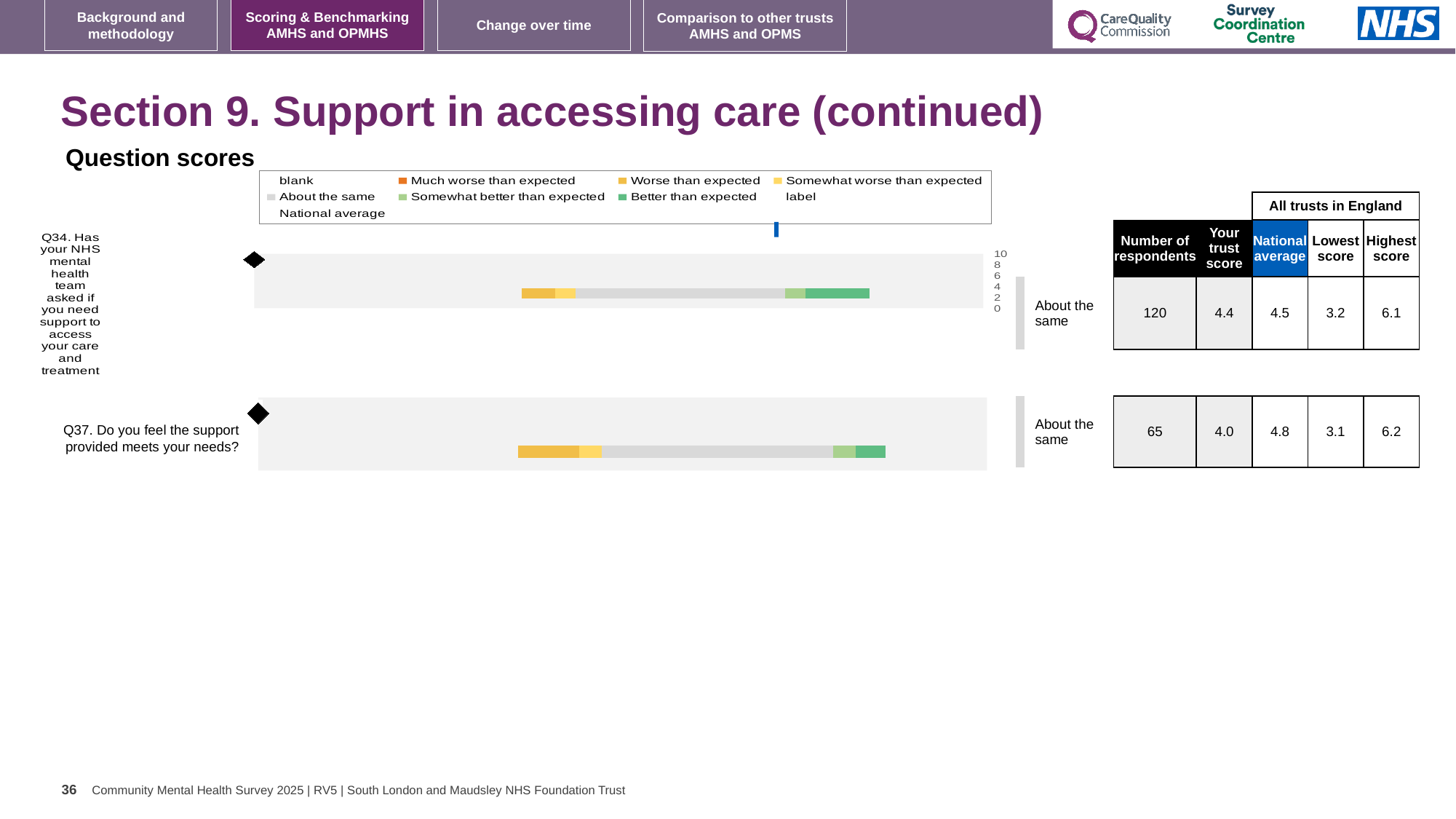
What benchmark category is shown next to the bar for Q37? About the same What is the number of respondents for Q34 (Has your NHS mental health team asked if you need support to access your care and treatment)? 120 What is the lowest score among all trusts in England for Q34? 3.2 Which is larger for Q34, the trust score or the national average? National average What is the national average for Q37 (Do you feel the support provided meets your needs)? 4.8 Which question has more respondents, Q34 or Q37? Q34 What is the trust score for Q34? 4.4 How many questions are plotted in the question scores chart? 2 What kind of chart is used to show the question scores for Q34 and Q37? Bar chart What is the highest score among all trusts in England for Q37? 6.2 How many more respondents answered Q34 than Q37? 55 What is the difference between the highest score and the lowest score for Q37? 3.1